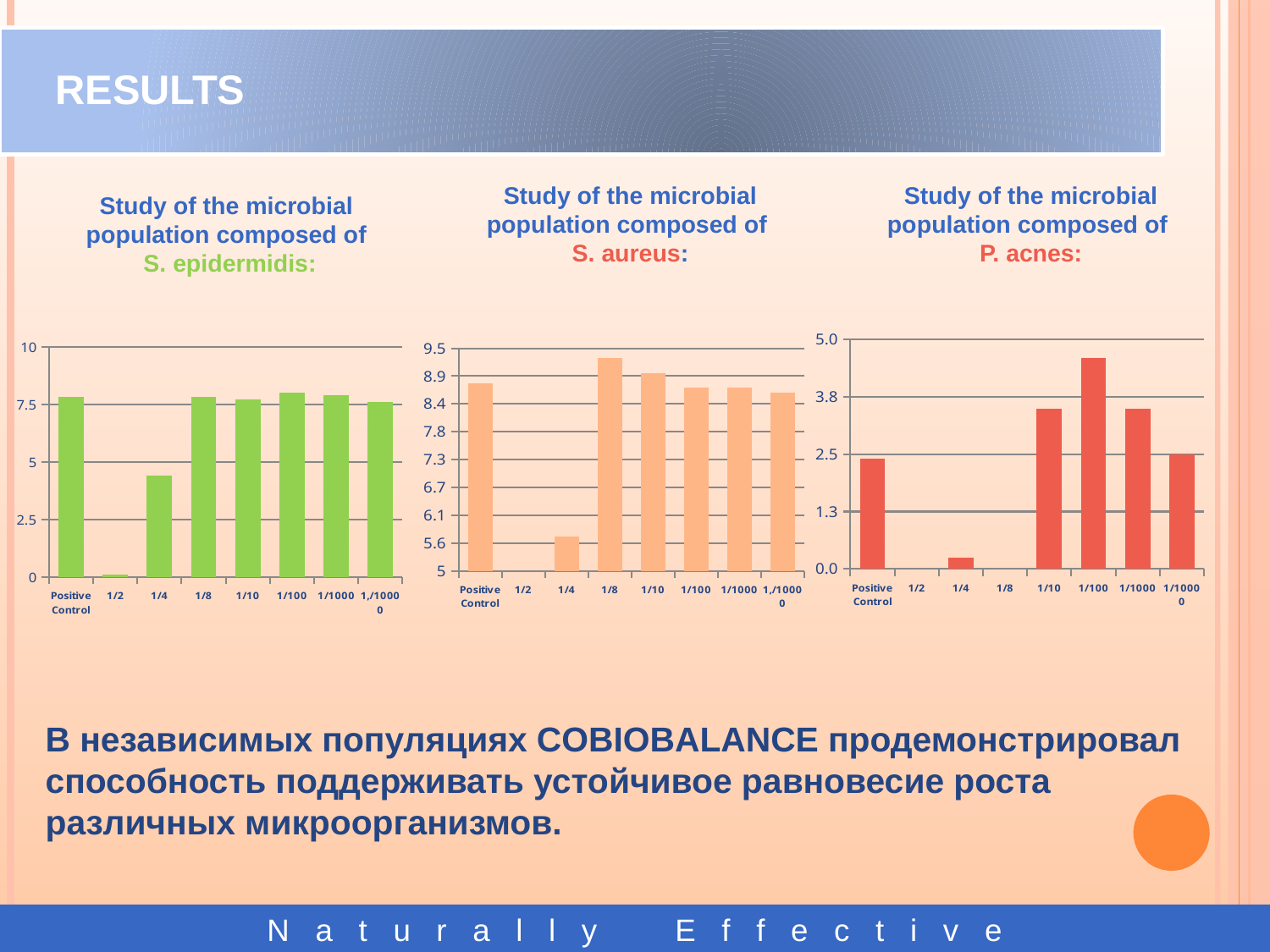
In the S. aureus chart, which category has the highest value? 1/8 What type of chart is used for the S. epidermidis study? bar chart What colour are the bars in the P. acnes chart? red In the S. aureus chart, is the value for 1/4 greater or less than 6.1? less In the P. acnes chart, which is larger, the value for 1/10 or the value for Positive Control? 1/10 In the S. epidermidis chart, is the value for Positive Control greater or less than 7.5? greater How many categories are shown on the x axis of the S. aureus chart? 8 In the P. acnes chart, is the value for 1/100 greater or less than 3.8? greater In the S. aureus chart, which is larger, the value for 1/8 or the value for 1/4? 1/8 In the S. epidermidis chart, which category has the lowest value? 1/2 In the P. acnes chart, which category has the highest value? 1/100